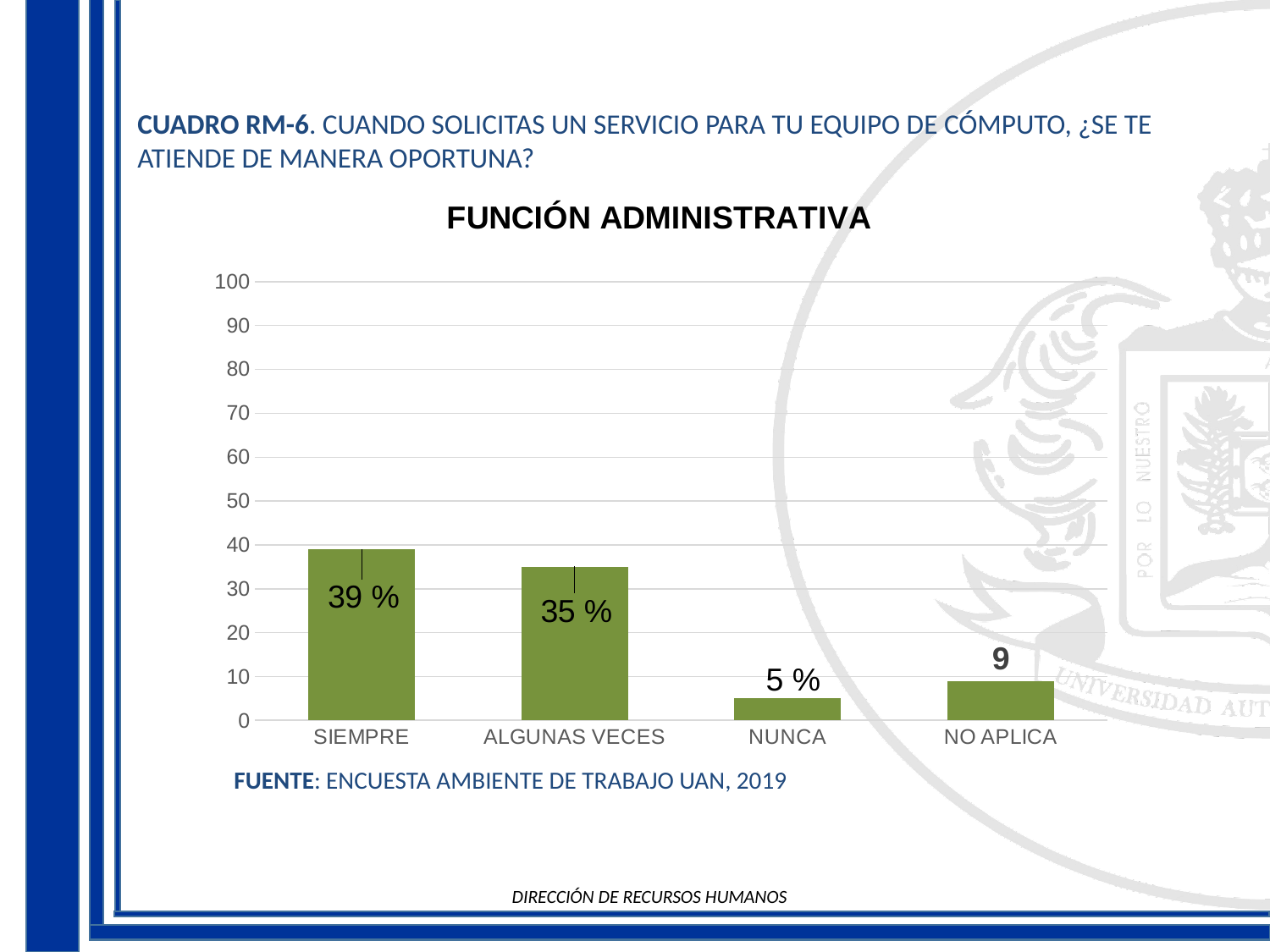
What is the value for SIEMPRE? 39 % What is the value for NUNCA? 5 % What is the value shown for NO APLICA? 9 What type of chart is shown on the slide? bar chart Which category has the lowest value? NUNCA What is the value for ALGUNAS VECES? 35 % Which is larger, the value for NO APLICA or the value for NUNCA? NO APLICA How many categories are shown on the x axis? 4 What is the title of the chart? FUNCIÓN ADMINISTRATIVA What is the difference between the values for SIEMPRE and ALGUNAS VECES? 4 % Which category has the highest value? SIEMPRE Is the value for SIEMPRE greater or less than 50? less